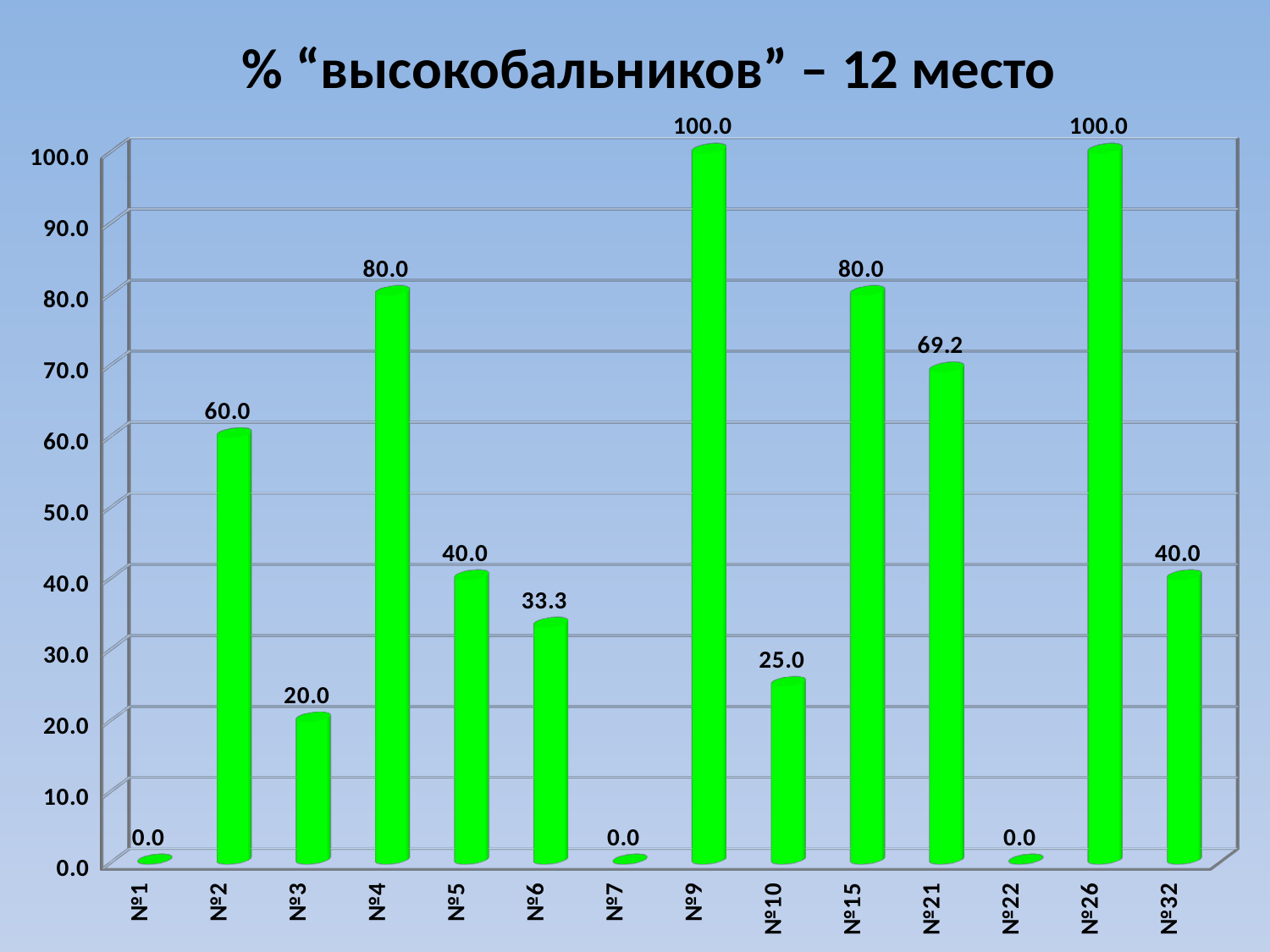
How many categories are shown on the x axis? 14 What is the title of the chart? % “высокобальников” – 12 место What is the value for №6? 33.3 Which has a larger value, №10 or №32? №32 What is the difference between the values for №15 and №21? 10.8 What kind of chart is shown on the slide? Bar chart What is the value for №21? 69.2 What is the value for №10? 25.0 What is the value for №4? 80.0 Which has a larger value, №5 or №6? №5 What is the difference between the values for №2 and №3? 40.0 What is the highest value shown on the chart? 100.0